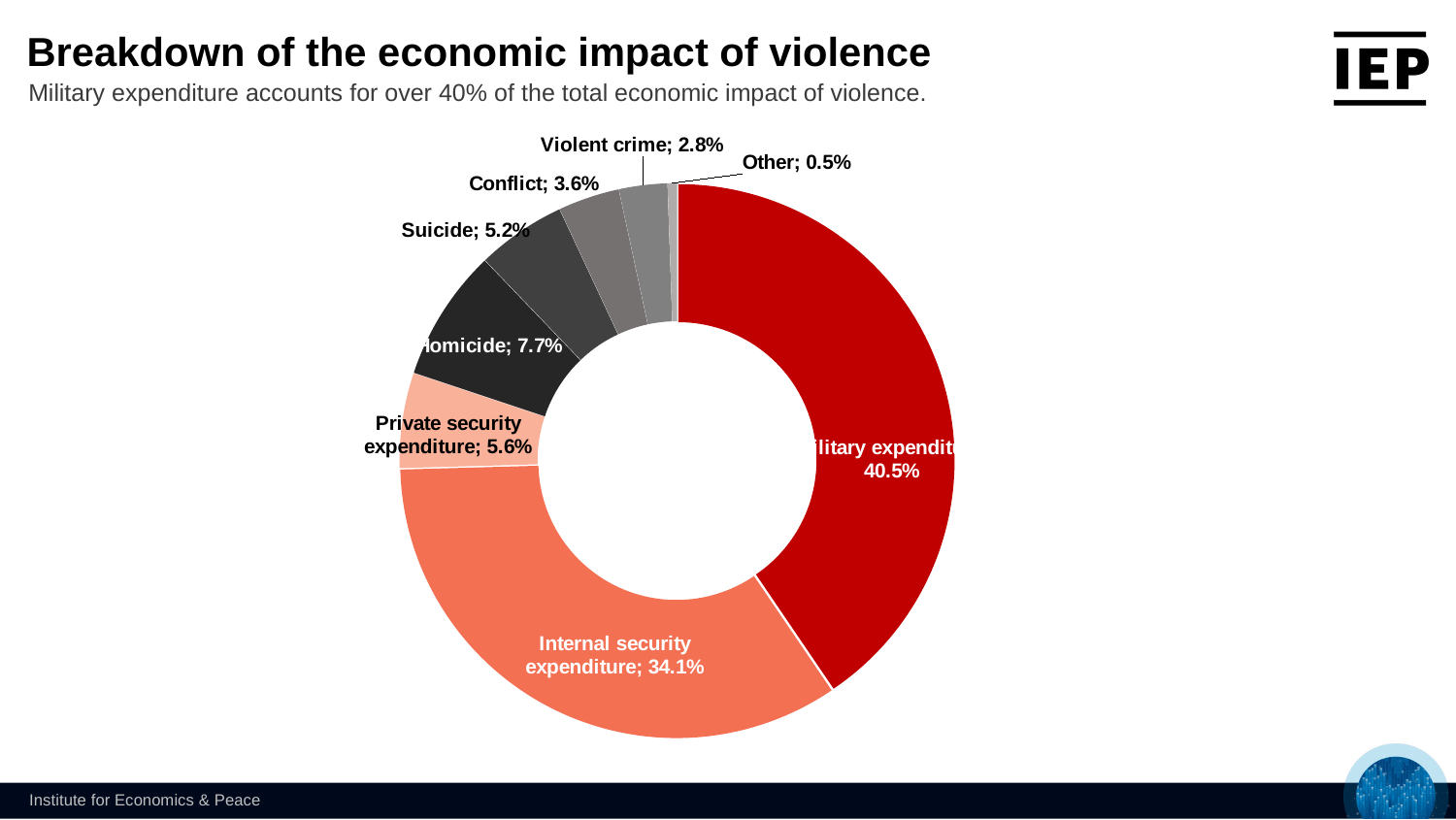
What percentage is shown for Violent crime? 2.8% What percentage is shown for Homicide? 7.7% What percentage is shown for Private security expenditure? 5.6% Which category has the largest share of the economic impact of violence? Military expenditure How many categories are shown in the chart? 8 Which is larger: the share for Suicide or the share for Homicide? Homicide What share of the economic impact of violence is attributed to Internal security expenditure? 34.1% What is the difference in percentage points between Military expenditure (40.5%) and Internal security expenditure (34.1%)? 6.4 percentage points What is the title of the chart on the slide? Breakdown of the economic impact of violence What percentage is shown for Conflict? 3.6% What kind of chart is shown on the slide? Pie (donut) chart Which category has the smallest share of the economic impact of violence? Other